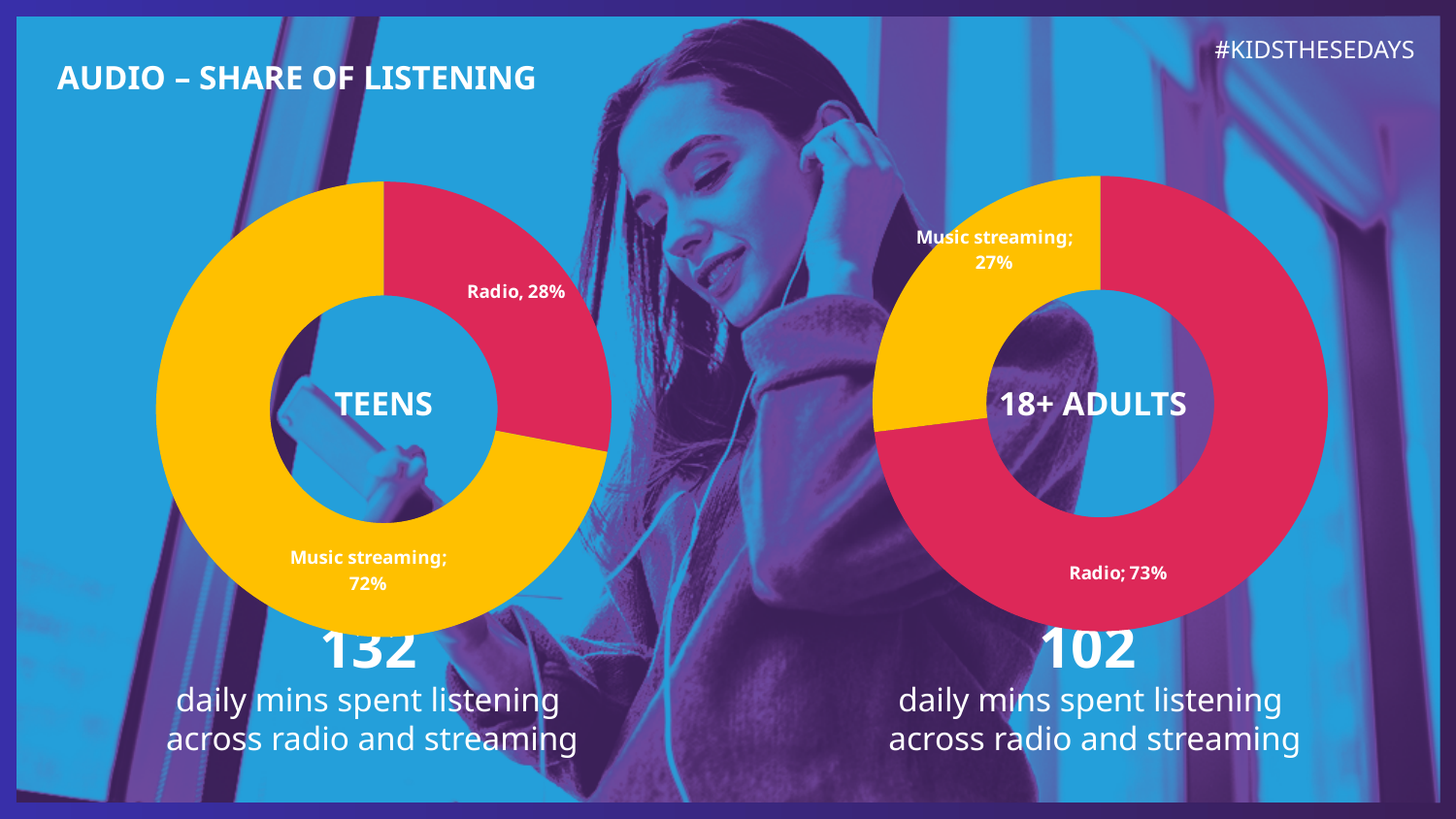
In the 18+ ADULTS chart, what share of listening is Radio? 73% In the TEENS chart, what is the difference between the Music streaming and Radio shares? 44 percentage points In the TEENS chart, what share of listening is Music streaming? 72% In the 18+ ADULTS chart, which category has the smallest share? Music streaming In the TEENS chart, which category has the largest share? Music streaming How many categories does the TEENS chart show? 2 In the 18+ ADULTS chart, what is the difference between the Radio and Music streaming shares? 46 percentage points Is the Radio share larger in the TEENS chart or the 18+ ADULTS chart? 18+ ADULTS In the TEENS chart, what share of listening is Radio? 28% What kind of chart is the 18+ ADULTS chart? Doughnut (pie) chart What colour represents Radio in both charts? Red In the 18+ ADULTS chart, what share of listening is Music streaming? 27%